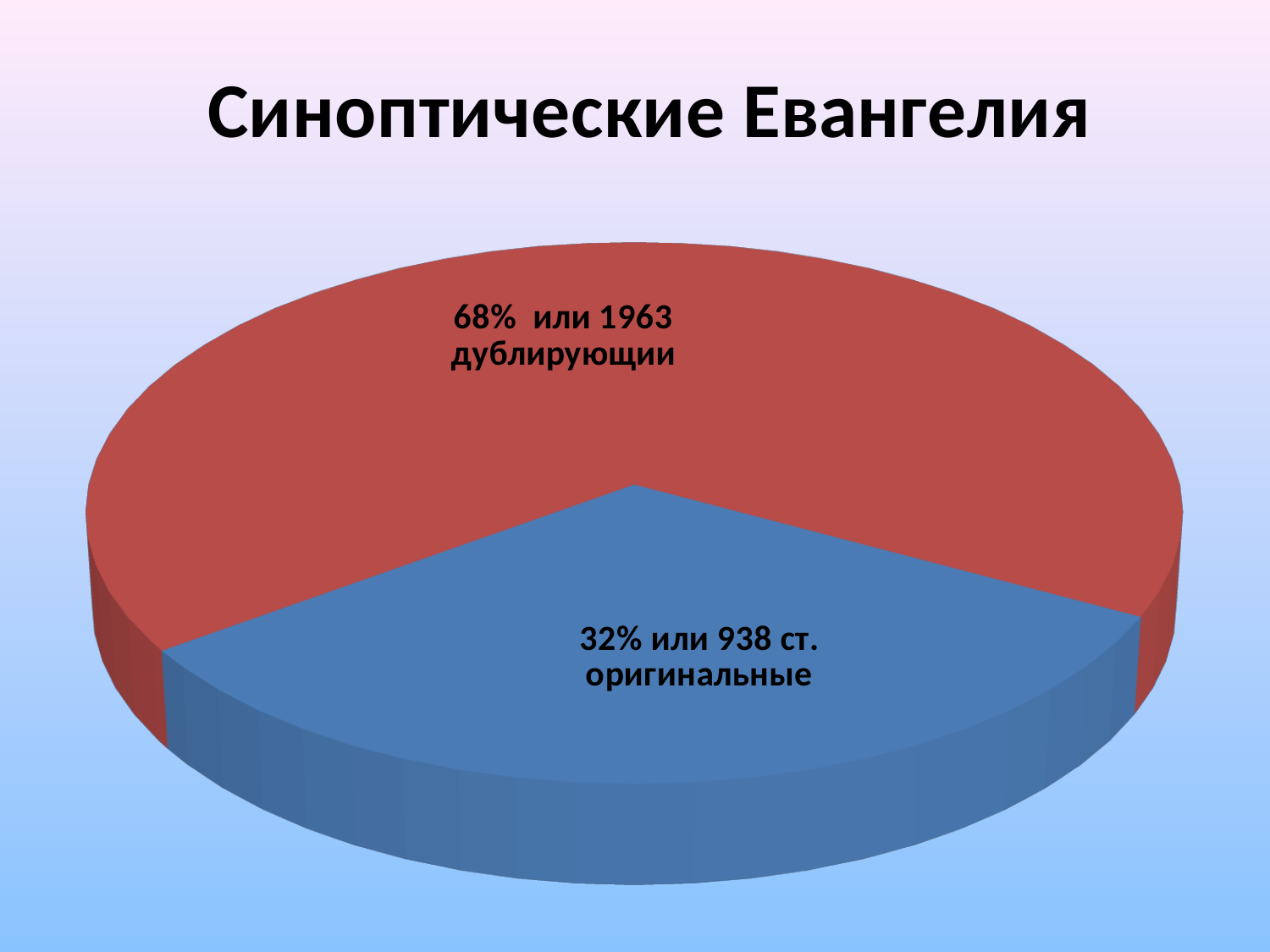
What colour is the 'оригинальные' slice? blue What kind of chart is shown on the slide? pie chart What is the title of the chart? Синоптические Евангелия How many verses are labelled as 'дублирующии'? 1963 Which is larger, the 'дублирующии' slice or the 'оригинальные' slice? дублирующии How many verses are labelled as 'оригинальные'? 938 ст. What is the difference in percentage points between the 'дублирующии' and 'оригинальные' slices? 36% How many slices does the pie chart have? 2 What percentage share does the 'оригинальные' slice have? 32% What percentage share does the 'дублирующии' slice have? 68% Which slice is the smallest? оригинальные Which slice is the largest? дублирующии